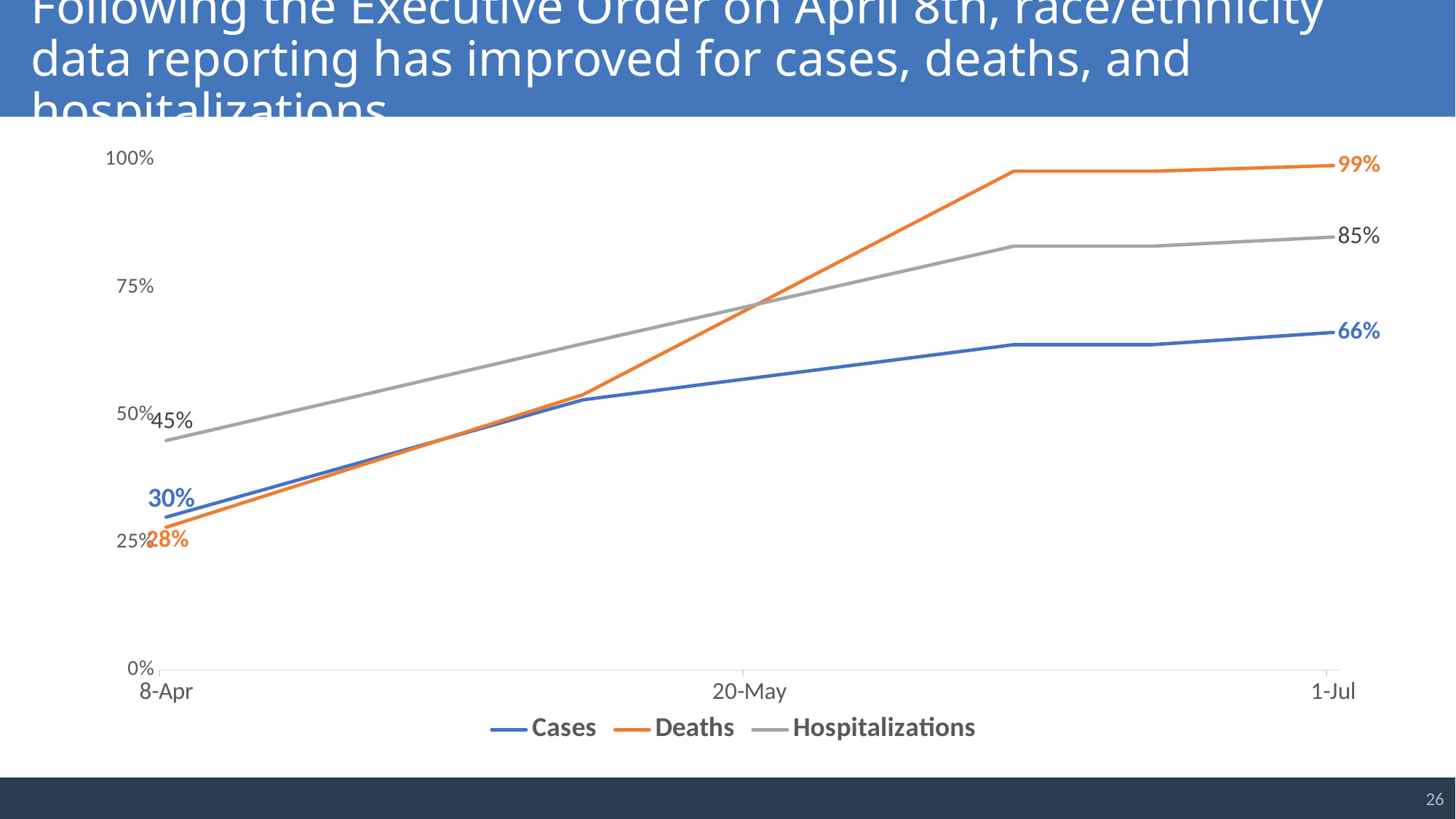
What is the value for Deaths on 1-Jul? 99% Which is larger on 1-Jul, Hospitalizations or Cases? Hospitalizations What is the value for Cases on 1-Jul? 66% What type of chart is shown on the slide? line chart How many series does the legend list? 3 Is the value for Hospitalizations on 20-May greater or less than 50%? greater Which series has the highest value on 1-Jul? Deaths Do the values for Deaths rise or fall from 8-Apr to 1-Jul? rise What is the value for Deaths on 8-Apr? 28% What is the difference between the Cases value on 1-Jul and on 8-Apr? 36% Which series has the lowest value on 8-Apr? Deaths What is the value for Hospitalizations on 8-Apr? 45%